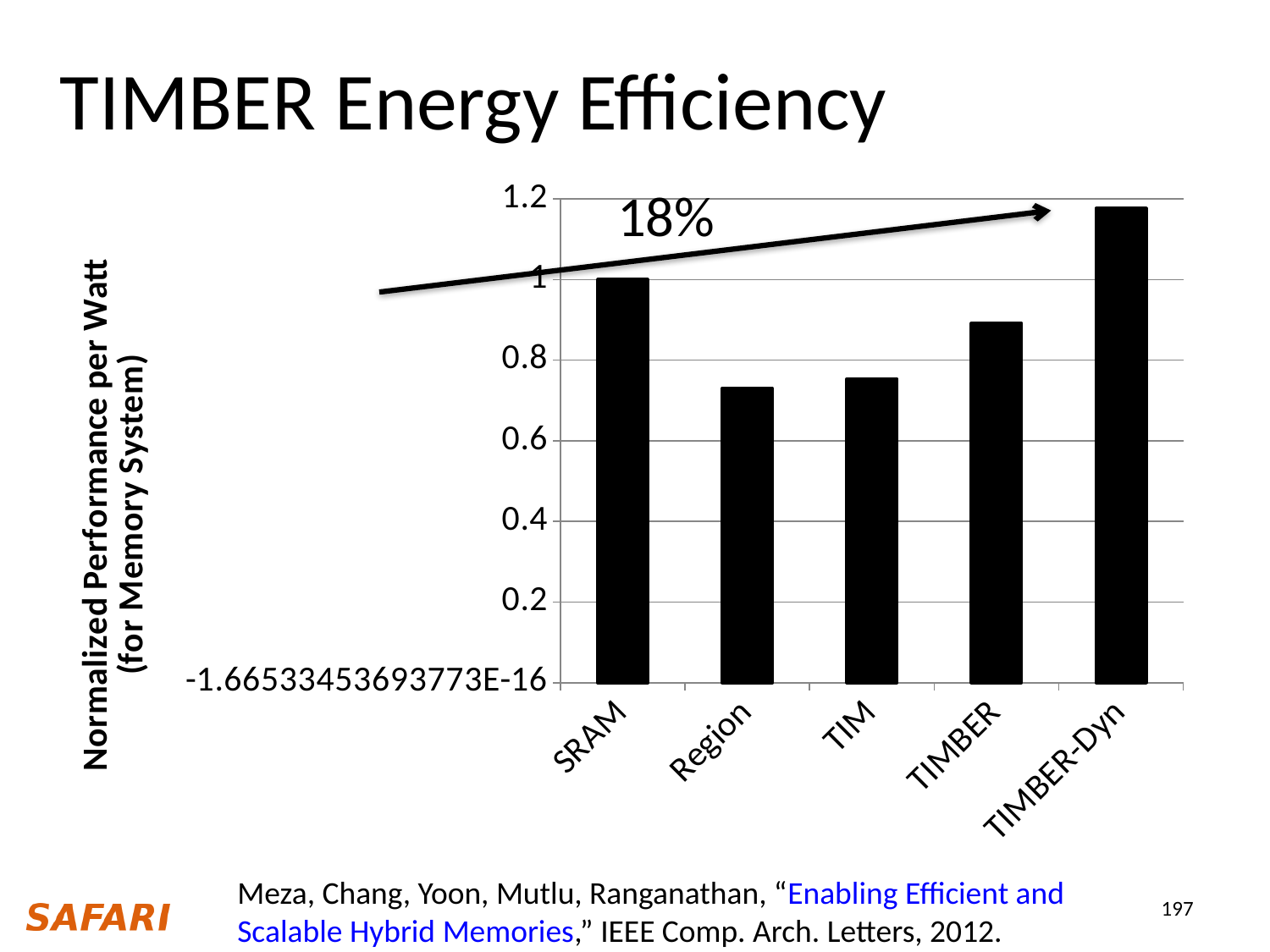
Which category has the highest normalized performance per watt? TIMBER-Dyn How many categories are shown on the x axis of the chart? 5 Is the value for TIM greater or less than 0.8? less Which has a higher normalized performance per watt, SRAM or TIMBER? SRAM What is the label of the y axis of the chart? Normalized Performance per Watt (for Memory System) Is the value for TIMBER-Dyn greater or less than 1? greater Is the value for TIMBER greater or less than 0.8? greater Which has a higher normalized performance per watt, TIMBER or Region? TIMBER What percentage is written next to the arrow annotation on the chart? 18% What is the normalized performance per watt for SRAM? 1 What kind of chart is shown on the slide? bar chart